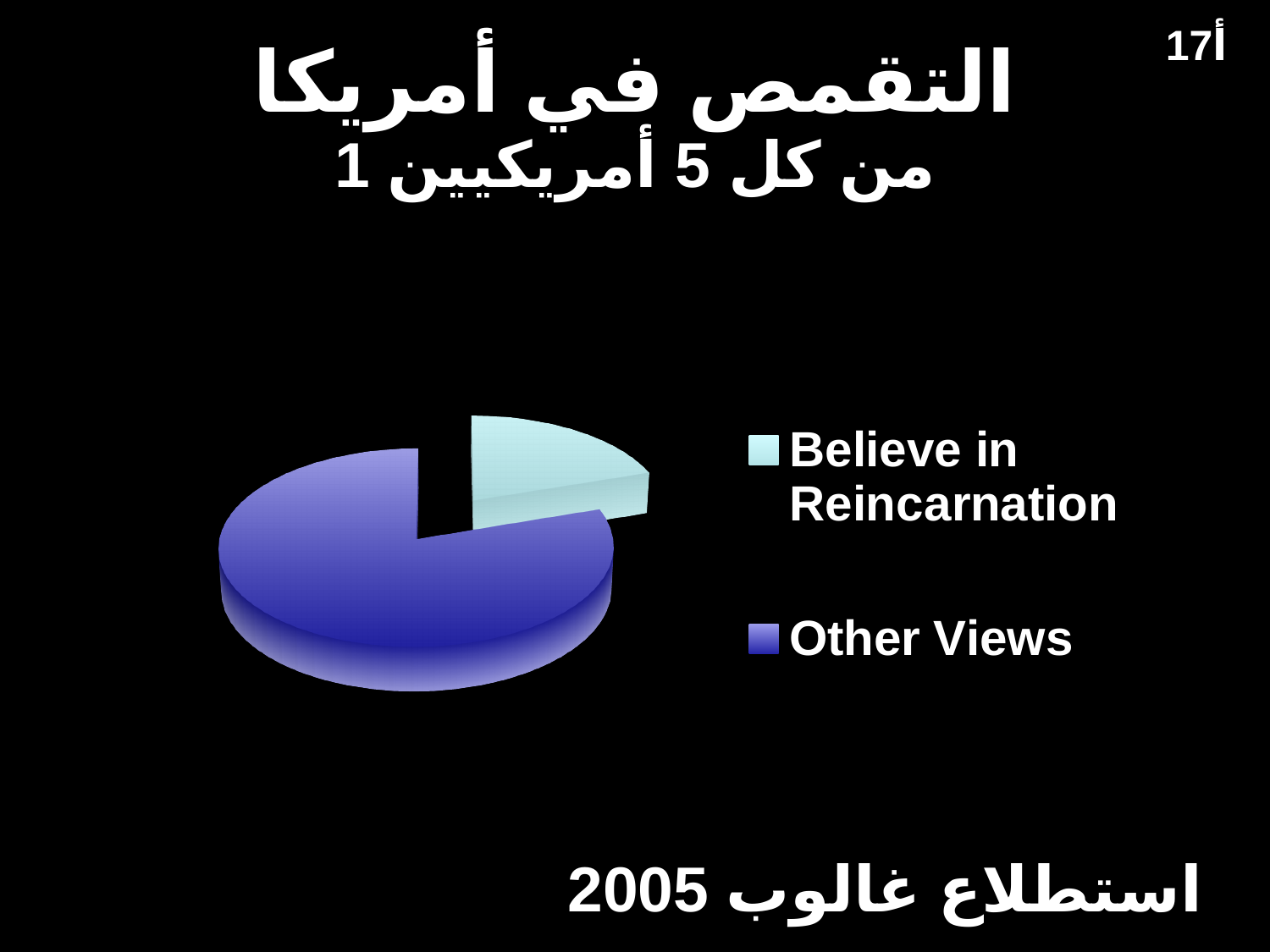
Which legend entry is shown in blue in the pie chart? Other Views What kind of chart is shown on the slide? pie chart What colour is the Believe in Reincarnation slice in the pie chart? light cyan How many entries does the legend of the pie chart list? 2 Which slice of the pie chart is the largest? Other Views Which is larger in the pie chart: Believe in Reincarnation or Other Views? Other Views How many slices does the pie chart have? 2 Which slice of the pie chart is the smallest? Believe in Reincarnation